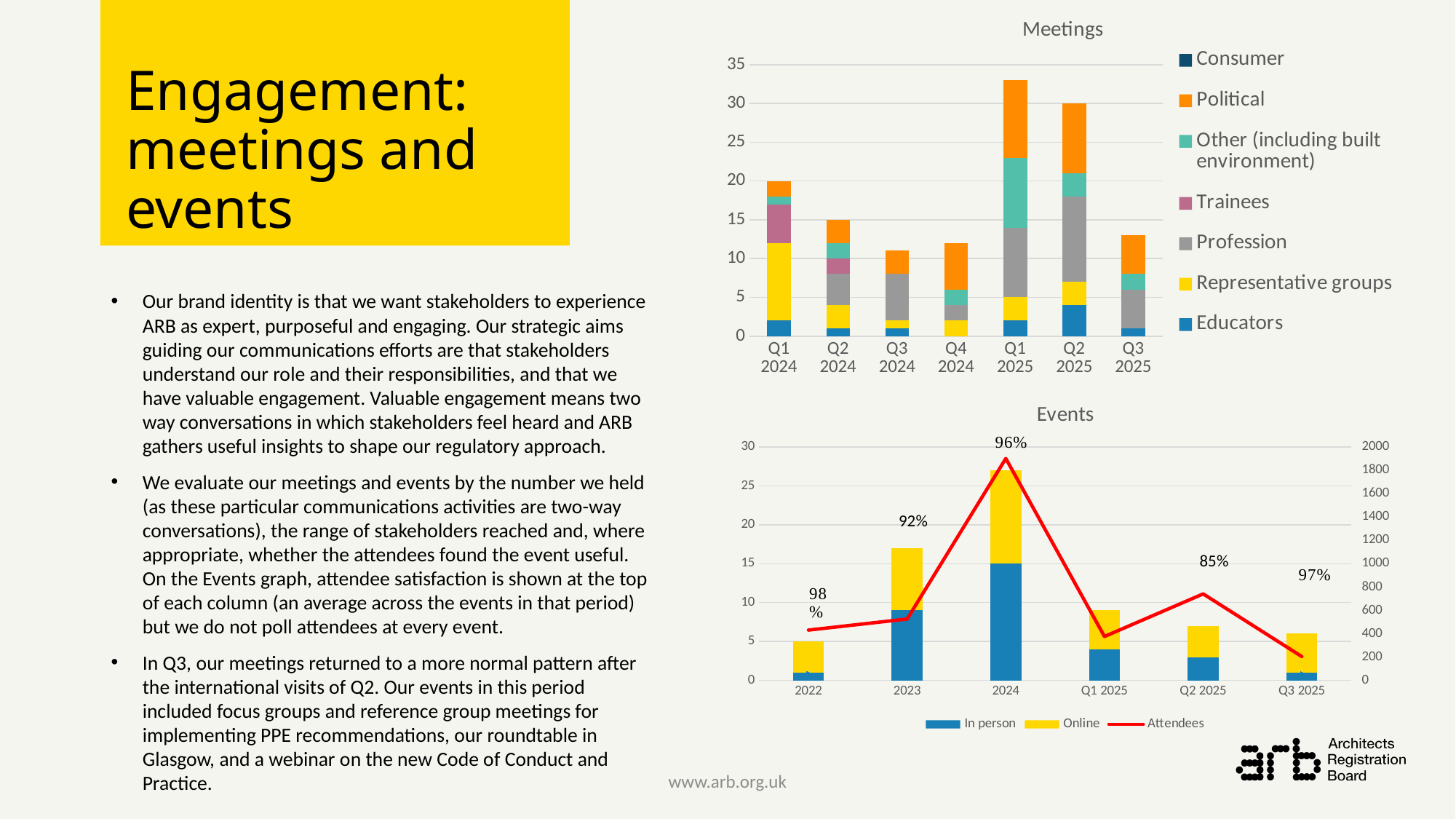
On the Meetings chart, which series is shown in orange? Political On the Events chart, how many series does the legend list? 3 On the Meetings chart, is the total for Q3 2024 greater or less than 15? less On the Events chart, is the number of attendees in 2024 greater or less than 1800? greater On the Events chart, what is the difference between the satisfaction percentages shown for 2024 and 2023? 4 percentage points On the Meetings chart, which quarter has the highest total number of meetings? Q1 2025 On the Meetings chart, how many series does the legend list? 7 On the Events chart, which period has the lowest attendee satisfaction percentage shown? Q2 2025 On the Meetings chart, how many quarters are shown on the x axis? 7 On the Meetings chart, is the total for Q1 2025 greater or less than 30? greater What kind of chart is the Meetings chart? Stacked bar chart On the Events chart, what attendee satisfaction percentage is shown for 2024? 96%